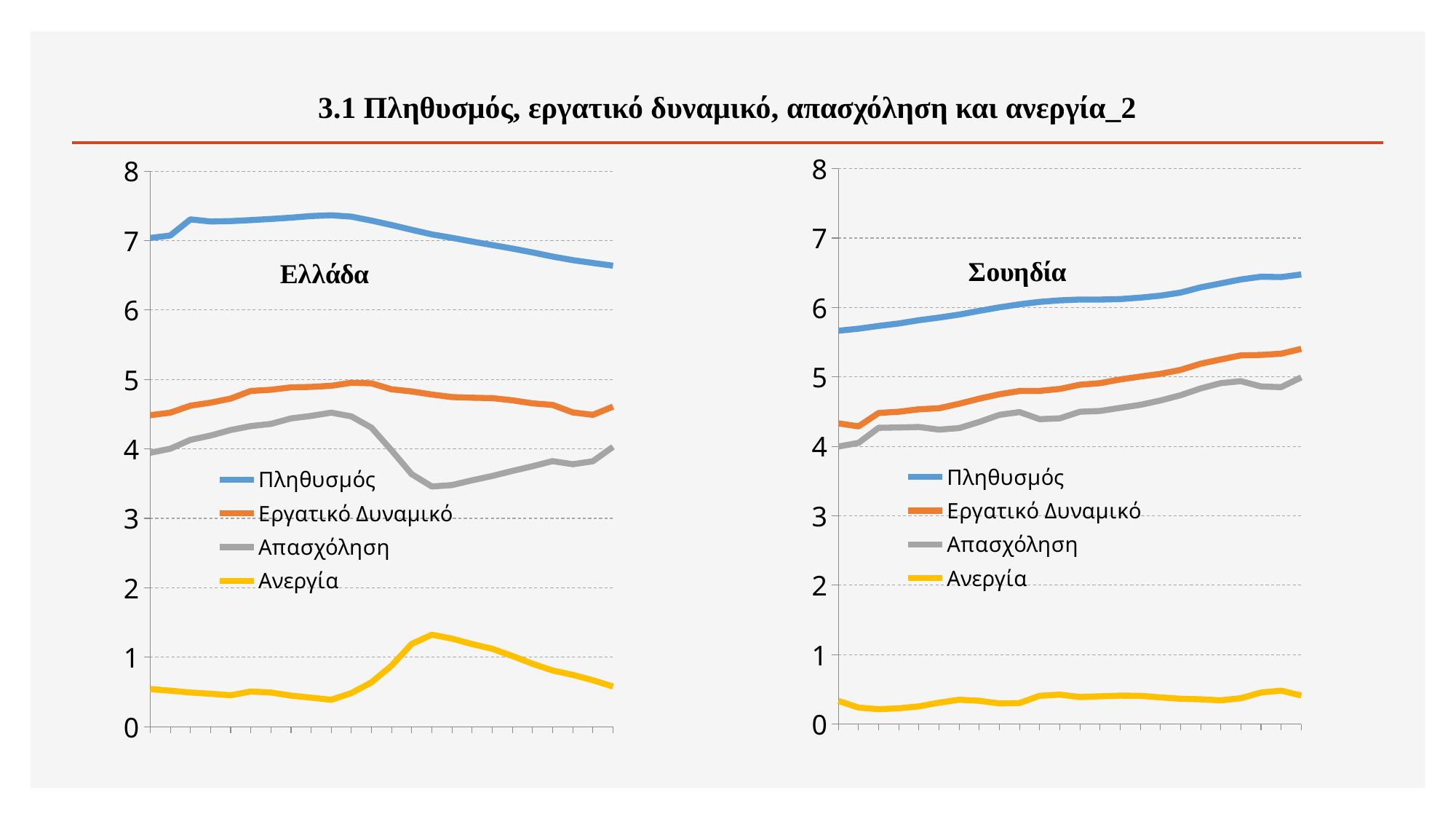
In the left chart (Ελλάδα), does the Πληθυσμός line rise or fall over the second half of the x axis? fall In the left chart (Ελλάδα), which series has the highest values throughout? Πληθυσμός In the right chart (Σουηδία), is the Ανεργία line greater or less than 1 throughout? less In the right chart (Σουηδία), which series has the lowest values throughout? Ανεργία In the right chart (Σουηδία), does the Πληθυσμός line rise or fall along the x axis? rise How many series does the legend of the right chart (Σουηδία) list? 4 In the left chart (Ελλάδα), is the peak value of the Ανεργία line greater or less than 1? greater In the left chart (Ελλάδα), which is larger at the right end of the x axis: Εργατικό Δυναμικό or Απασχόληση? Εργατικό Δυναμικό What kind of chart is the left chart labelled Ελλάδα? line chart In the right chart (Σουηδία), is the final value of the Πληθυσμός line greater or less than 6? greater Which chart shows a higher Πληθυσμός line at the right end of the x axis, Ελλάδα or Σουηδία? Ελλάδα What is the title of the slide? 3.1 Πληθυσμός, εργατικό δυναμικό, απασχόληση και ανεργία_2